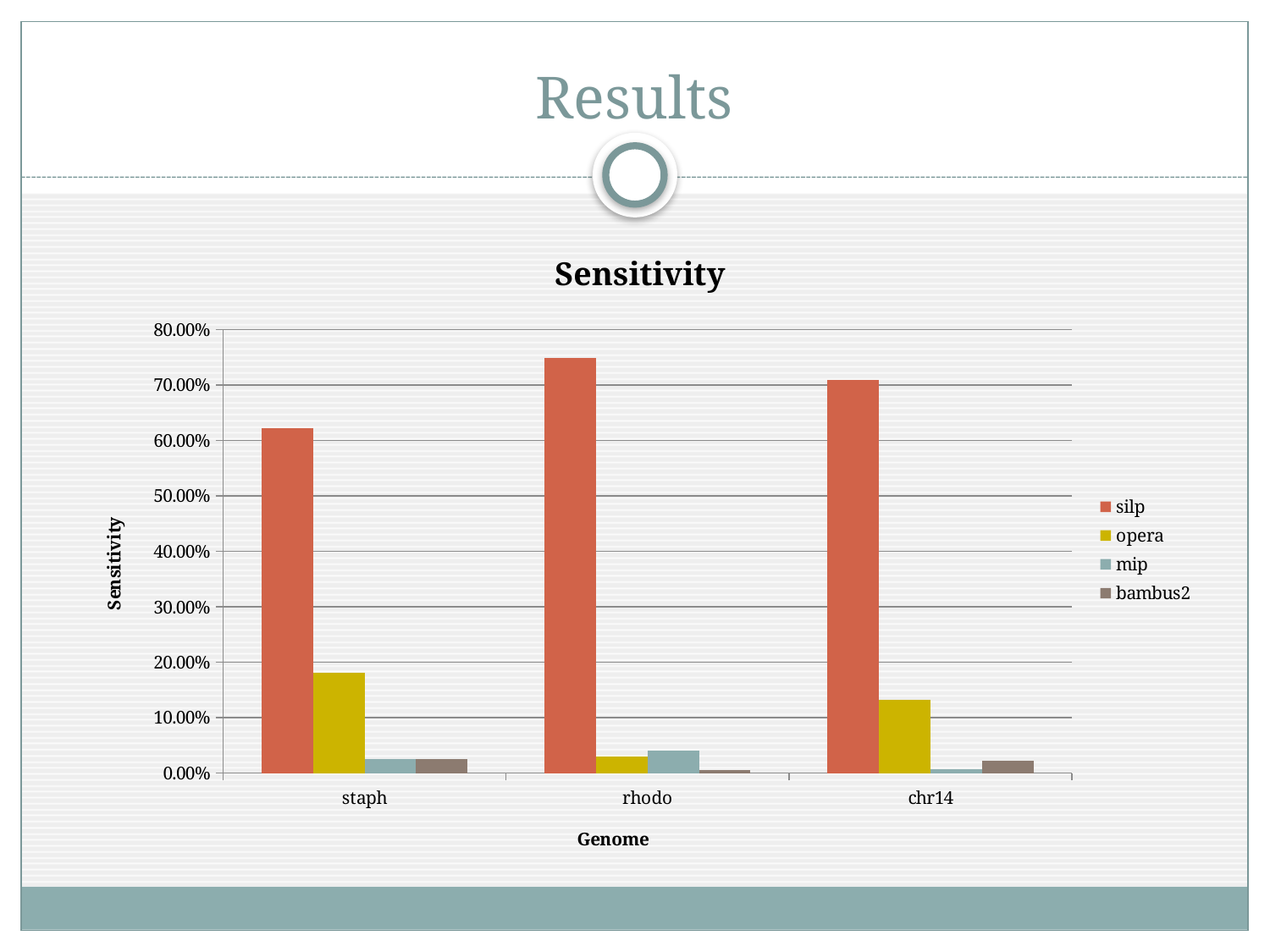
Which series has the highest value for chr14? silp What kind of chart is shown on the slide? bar chart Is the silp value for rhodo greater or less than 70.00%? greater What is the title of the chart? Sensitivity Is the opera value for chr14 greater or less than 10.00%? greater Is the opera value for staph greater or less than 20.00%? less Which genome has the lowest silp sensitivity? staph How many series does the legend list? 4 Which is larger, the opera value for staph or the opera value for chr14? staph How many genomes are shown on the x axis? 3 Which genome has the highest silp sensitivity? rhodo